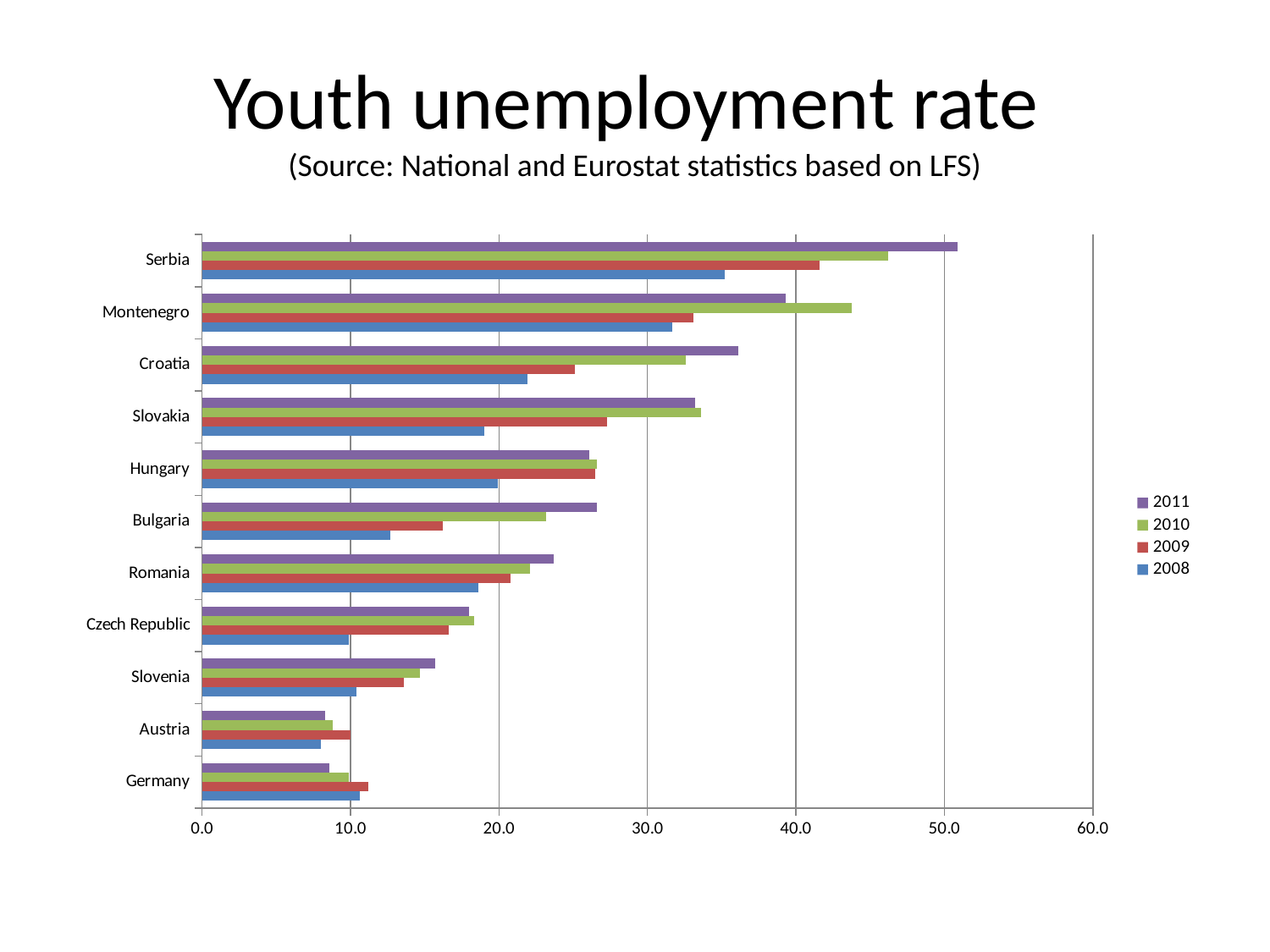
Is the 2011 value for Serbia greater or less than 40.0? greater Which country has the lowest youth unemployment rate for 2008? Austria Is the 2008 value for Bulgaria greater or less than 20.0? less Which has the larger 2011 value, Bulgaria or Romania? Bulgaria What is the title of the chart on the slide? Youth unemployment rate How many countries are shown on the chart? 11 Which country has the highest youth unemployment rate for 2011? Serbia For Montenegro, which year has the larger value, 2010 or 2011? 2010 Is the 2010 value for Montenegro greater or less than 40.0? greater What kind of chart is shown on the slide? Bar chart Which has the larger 2011 value, Croatia or Slovakia? Croatia How many series does the legend list? 4